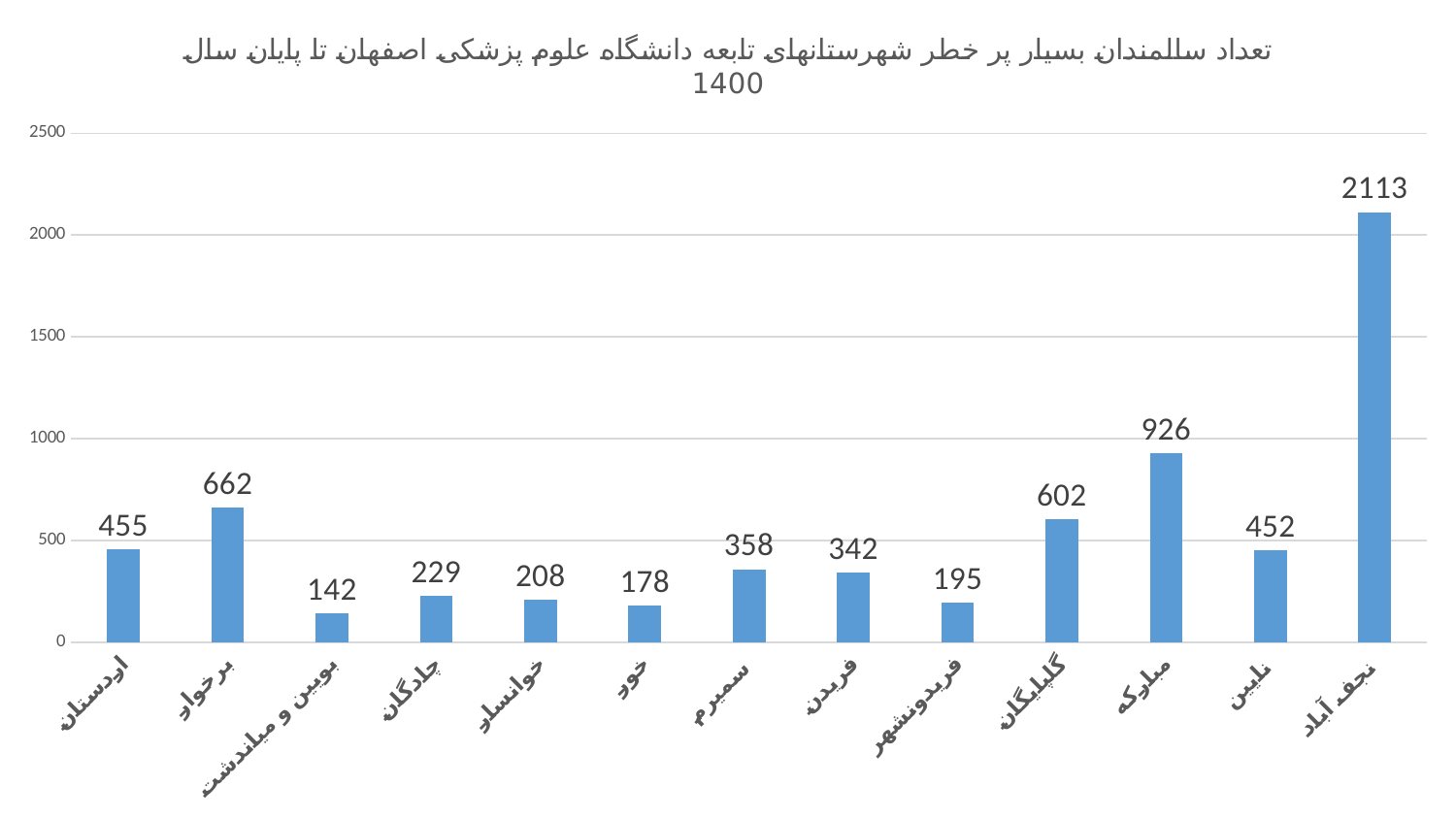
What is the value for خوانسار? 208 How many categories are shown on the x axis? 13 What is the value for مبارکه? 926 What is the maximum value shown on the vertical axis? 2500 What is the difference between the values for نجف آباد and مبارکه? 1187 Which category has the highest value? نجف آباد Which is larger, the value for سمیرم or the value for فریدن? سمیرم Is the value for مبارکه greater or less than 1000? less What is the difference between the values for برخوار and گلپایگان? 60 Which category has the lowest value? بویین و میاندشت What is the value for نجف آباد? 2113 What kind of chart is shown on the slide? bar chart